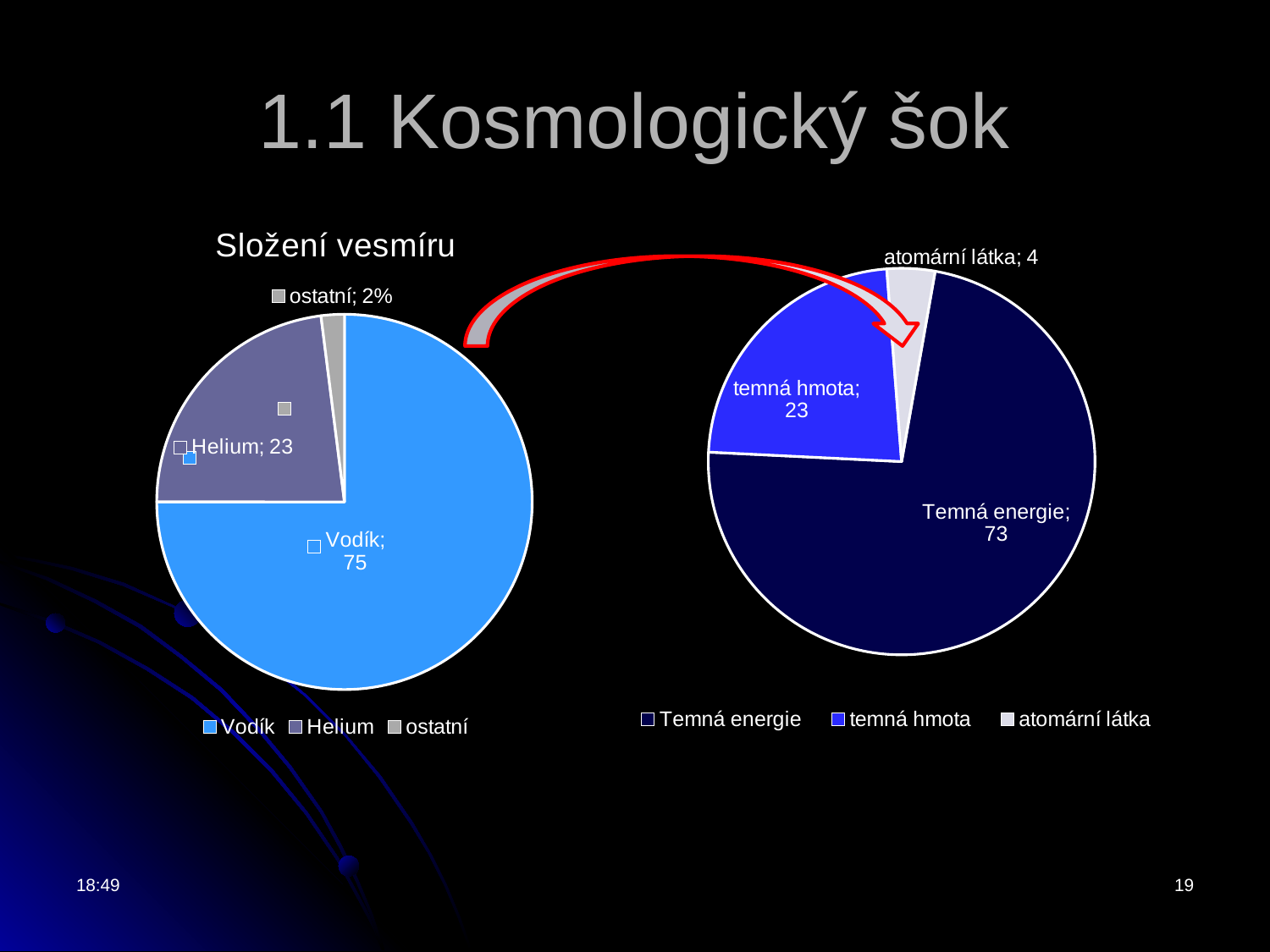
In the right pie chart, what is the difference between the values for Temná energie and temná hmota? 50 In the right pie chart, what is the value for atomární látka? 4 In the right pie chart, which category has the largest slice? Temná energie In the left chart titled 'Složení vesmíru', what is the value for Vodík? 75 In the left chart titled 'Složení vesmíru', which category has the smallest slice? ostatní In the left chart titled 'Složení vesmíru', which is larger, Vodík or Helium? Vodík In the left chart titled 'Složení vesmíru', what is the value for Helium? 23 How many entries does the legend of the right pie chart list? 3 In the left chart titled 'Složení vesmíru', what is the value shown for ostatní? 2% How many slices does the right pie chart have? 3 What type of chart is the left chart titled 'Složení vesmíru'? Pie chart In the right pie chart, what is the value for Temná energie? 73